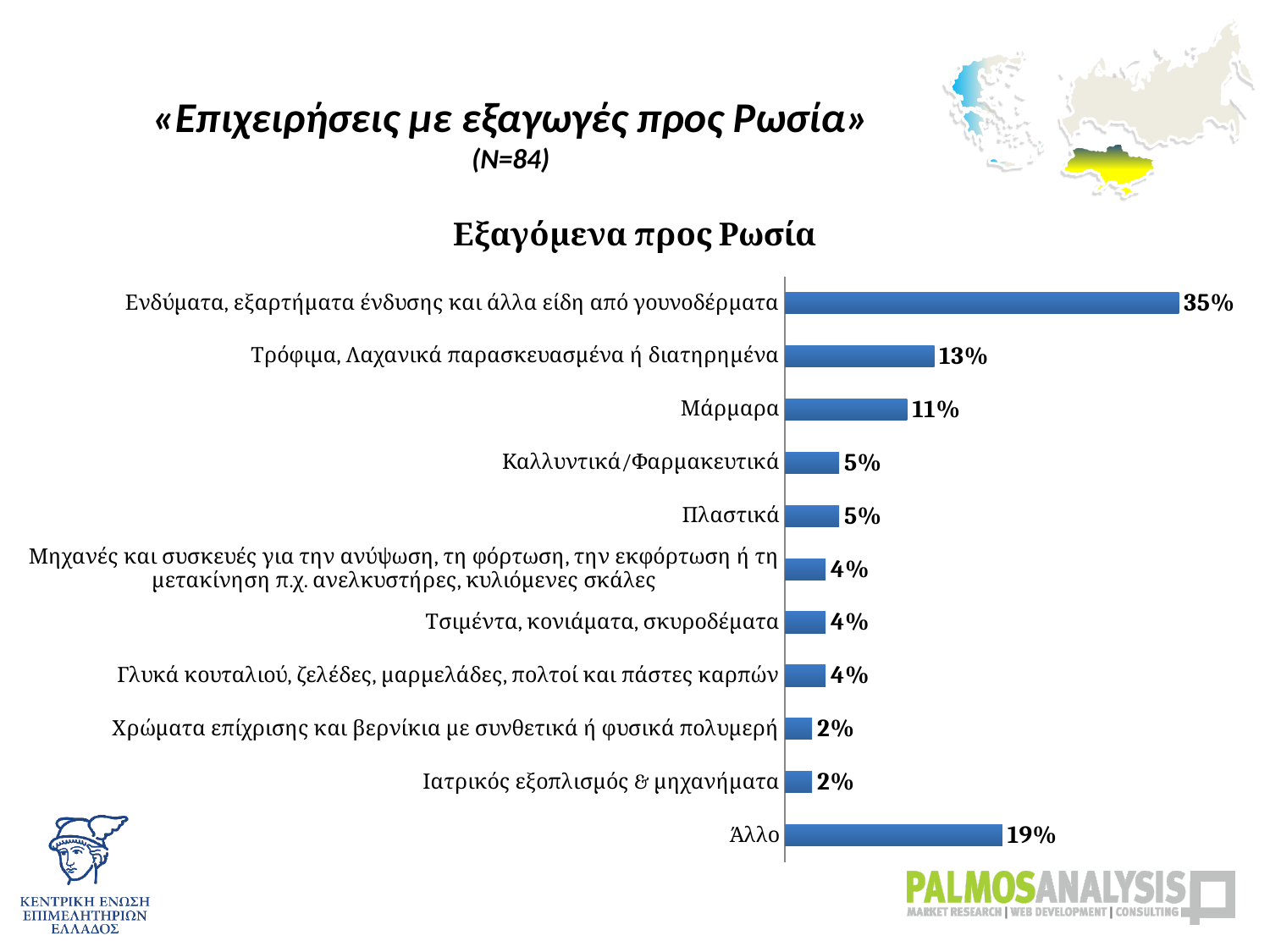
What is the sample size (N) stated on the slide? N=84 How many categories are shown in the chart? 11 What kind of chart is shown on the slide? Bar chart What is the title of the chart? Εξαγόμενα προς Ρωσία Which category has the highest value? Ενδύματα, εξαρτήματα ένδυσης και άλλα είδη από γουνοδέρματα Which is larger, the value for Μάρμαρα or the value for Καλλυντικά/Φαρμακευτικά? Μάρμαρα What is the difference between the values for Τρόφιμα, Λαχανικά παρασκευασμένα ή διατηρημένα and Μάρμαρα? 2% What is the difference between the values for Ενδύματα, εξαρτήματα ένδυσης και άλλα είδη από γουνοδέρματα and Άλλο? 16% What is the value for Τρόφιμα, Λαχανικά παρασκευασμένα ή διατηρημένα? 13% What is the value for Ιατρικός εξοπλισμός & μηχανήματα? 2% What is the value for Άλλο? 19% What is the value for Μάρμαρα? 11%